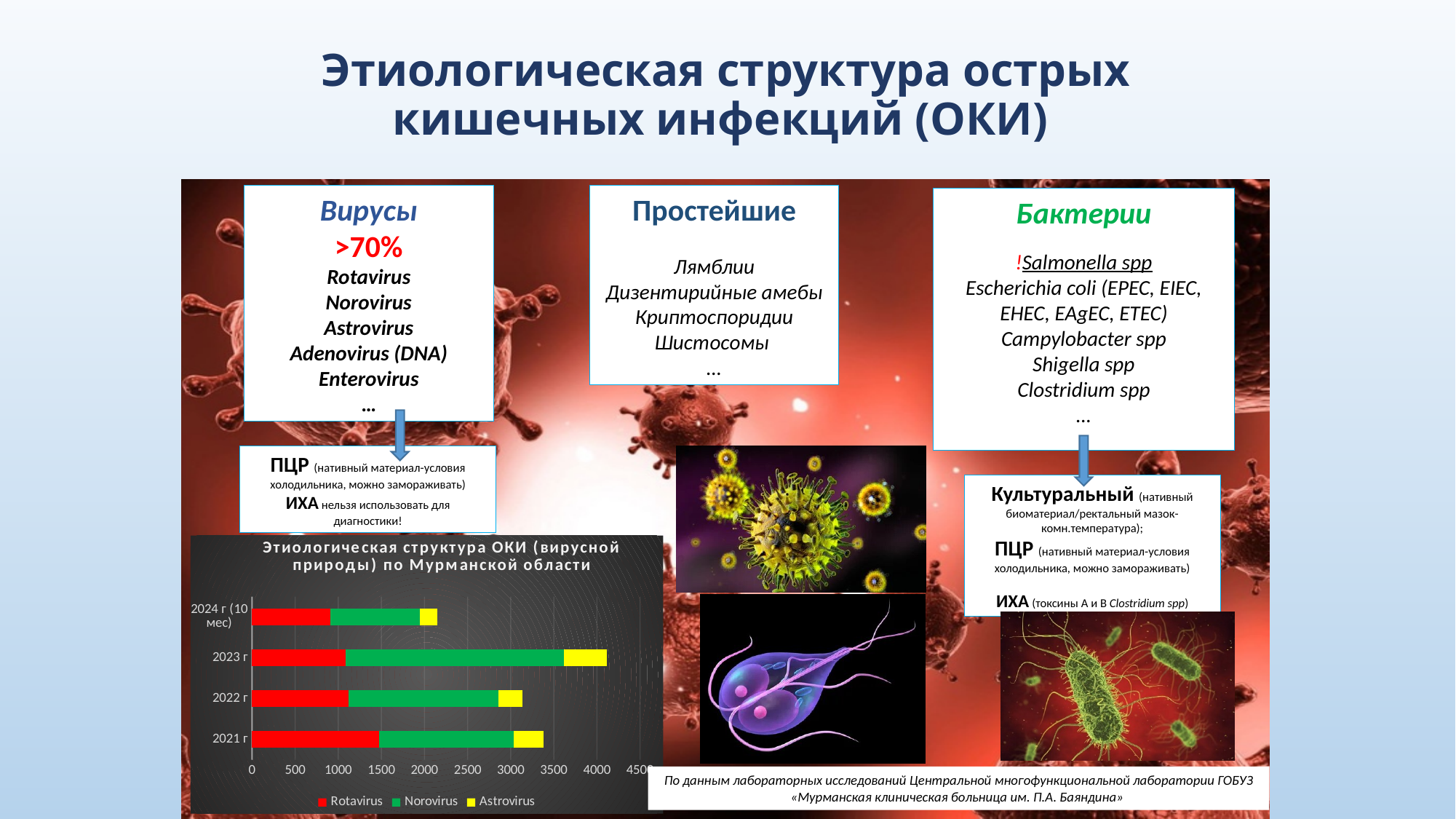
Which series is shown in yellow on the chart? Astrovirus Which year has the larger Rotavirus segment, 2021 г or 2024 г (10 мес)? 2021 г What is the title of the chart? Этиологическая структура ОКИ (вирусной природы) по Мурманской области Is the total bar length for 2023 г greater or less than 3500? greater Which year has the shortest total bar on the chart? 2024 г (10 мес) Is the total bar length for 2024 г (10 мес) greater or less than 2500? less Is the Rotavirus value for 2021 г greater or less than 1000? greater What kind of chart is shown on the slide? Stacked bar chart How many series does the chart legend list? 3 Which year has the larger Norovirus segment, 2023 г or 2022 г? 2023 г Which year has the longest total bar on the chart? 2023 г How many year categories are plotted on the chart? 4